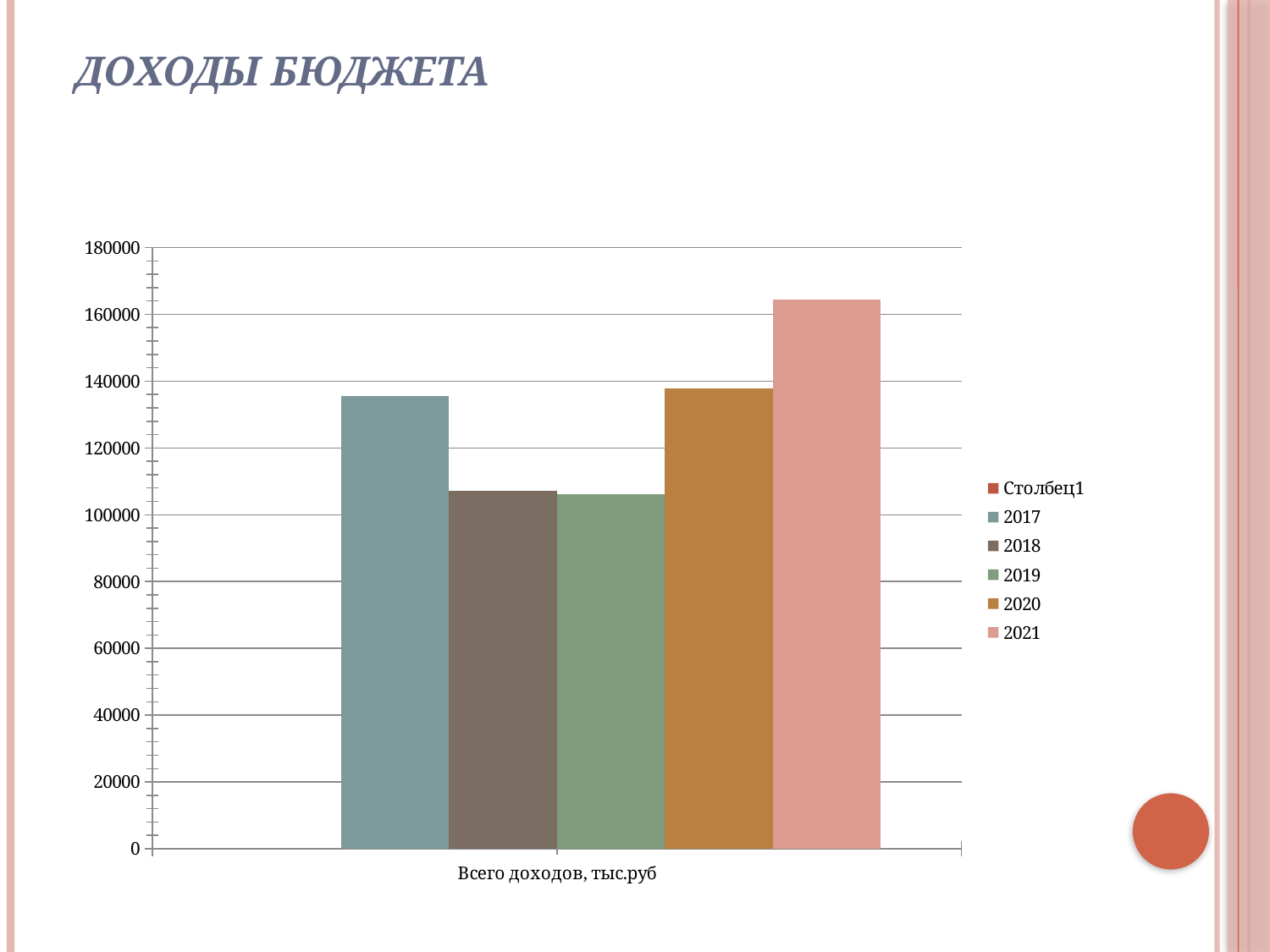
Which is larger, the value for 2017 or the value for 2018? 2017 Is the value for 2017 greater or less than 140000? less Is the value for 2019 greater or less than 120000? less Is the value for 2018 greater or less than 100000? greater What is the title of the slide containing the chart? ДОХОДЫ БЮДЖЕТА What is the category label shown on the x axis? Всего доходов, тыс.руб Which year has the highest value for Всего доходов, тыс.руб? 2021 How many series does the legend list? 6 Which is larger, the value for 2021 or the value for 2020? 2021 What kind of chart is shown on the slide? bar chart